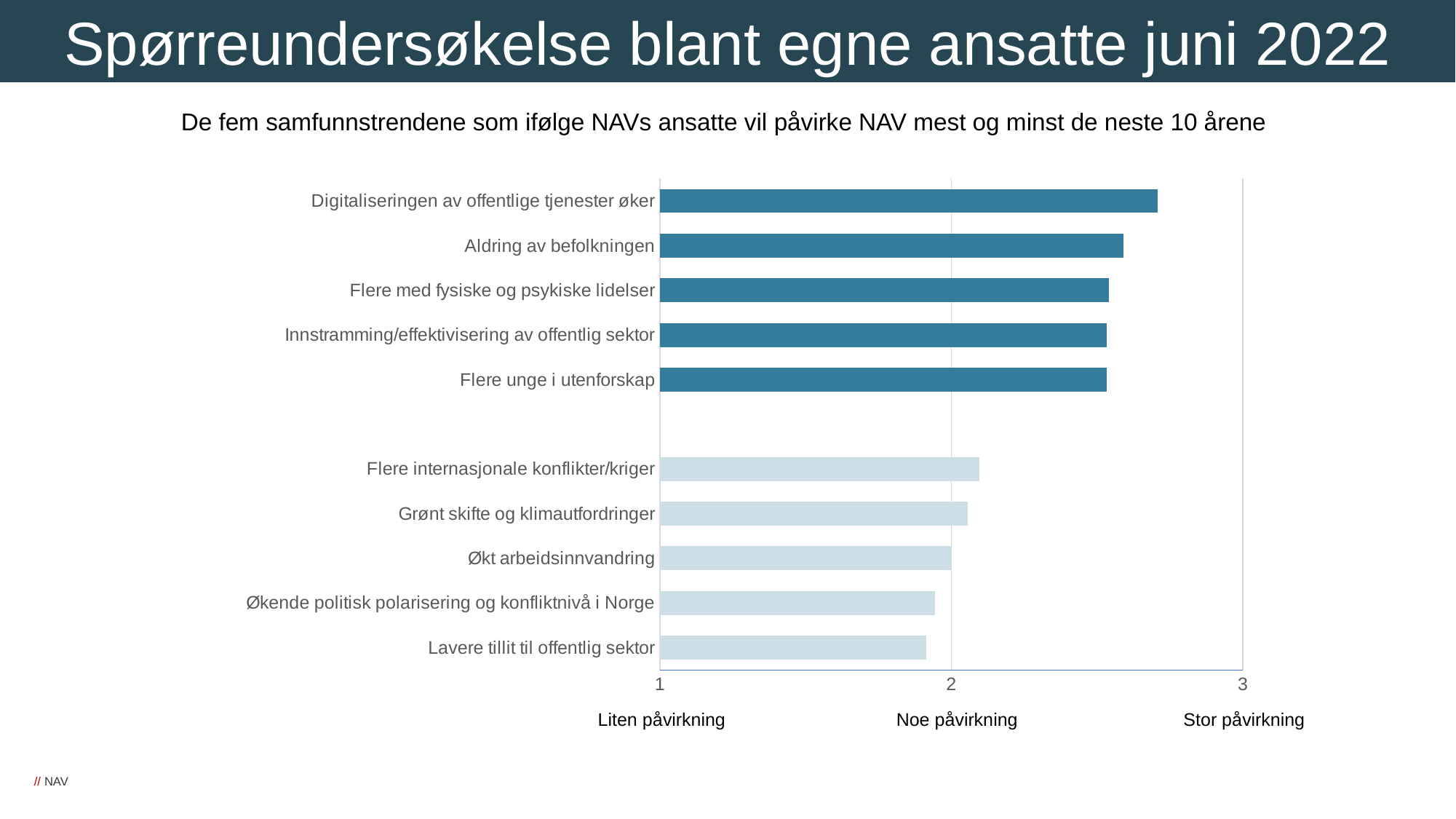
What kind of chart is shown on the slide? Bar chart Which has a larger value: Digitaliseringen av offentlige tjenester øker or Aldring av befolkningen? Digitaliseringen av offentlige tjenester øker Is the value for Lavere tillit til offentlig sektor greater or less than 2? less Which category has the highest value in the chart? Digitaliseringen av offentlige tjenester øker Is the value for Økende politisk polarisering og konfliktnivå i Norge greater or less than 2? less How many categories (trends) are plotted in the chart? 10 Is the value for Flere unge i utenforskap greater or less than 3? less Which has a larger value: Flere internasjonale konflikter/kriger or Flere med fysiske og psykiske lidelser? Flere med fysiske og psykiske lidelser What is the subtitle describing the chart? De fem samfunnstrendene som ifølge NAVs ansatte vil påvirke NAV mest og minst de neste 10 årene What label is shown under the axis value 3? Stor påvirkning